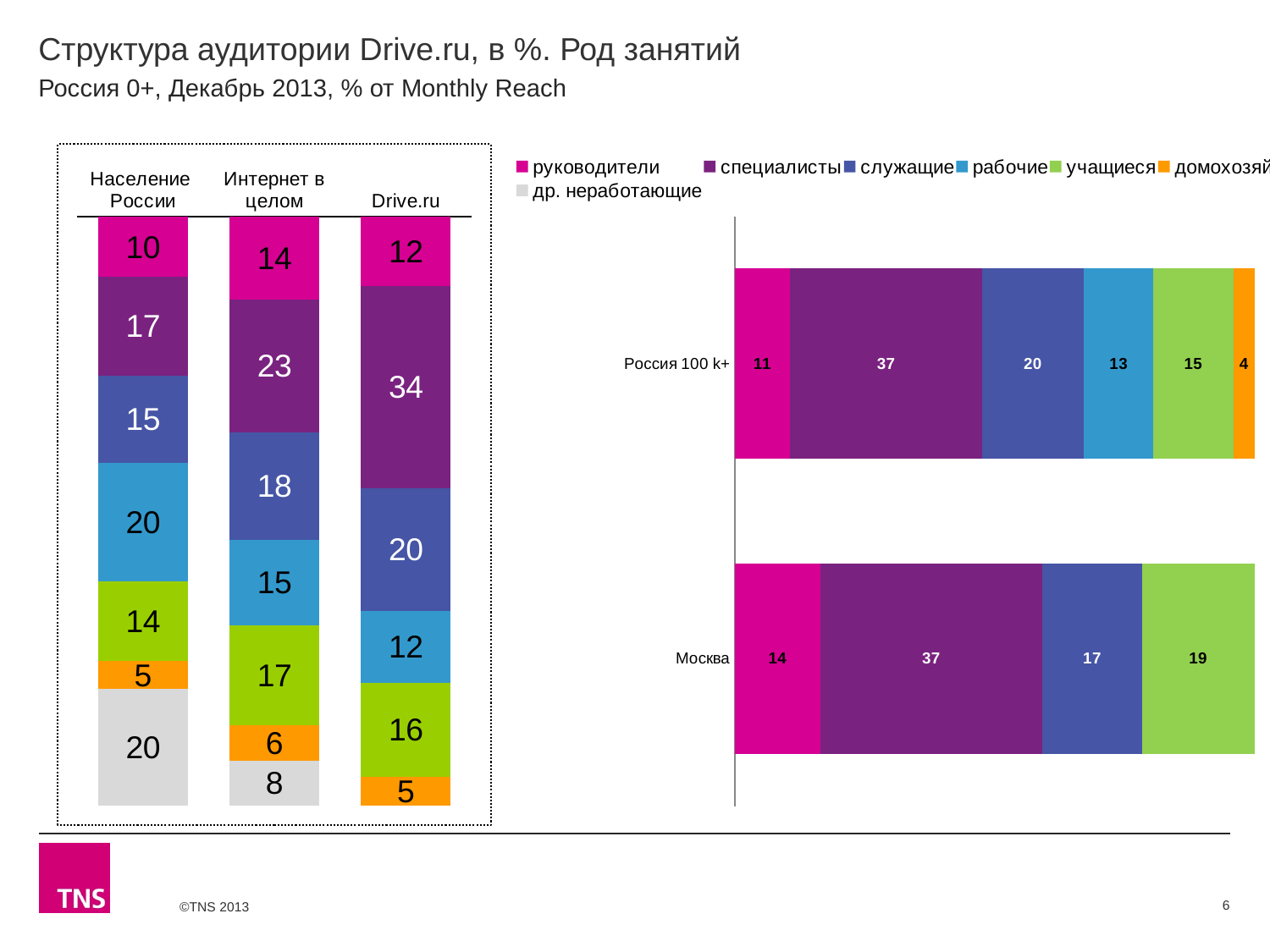
In the right chart, what is the total of the labelled segments for Россия 100 k+? 100 In the right chart, what is the value for специалисты for Россия 100 k+? 37 In the left chart, what is the value of the purple (специалисты) segment for Drive.ru? 34 In the right chart, what is the value for учащиеся for Москва? 19 What type of chart is the chart on the right? Stacked bar chart In the right chart, which is larger for руководители: Россия 100 k+ or Москва? Москва How many series does the legend on the right list? 7 In the left chart, how many bars (categories) are shown? 3 In the left chart, what is the value of the top pink segment for Интернет в целом? 14 In the left chart, which of the three bars has the largest purple (специалисты) segment? Drive.ru In the left chart, what is the difference between the purple segment for Drive.ru and the purple segment for Интернет в целом? 11 In the left chart, what is the value of the grey bottom segment for Население России? 20